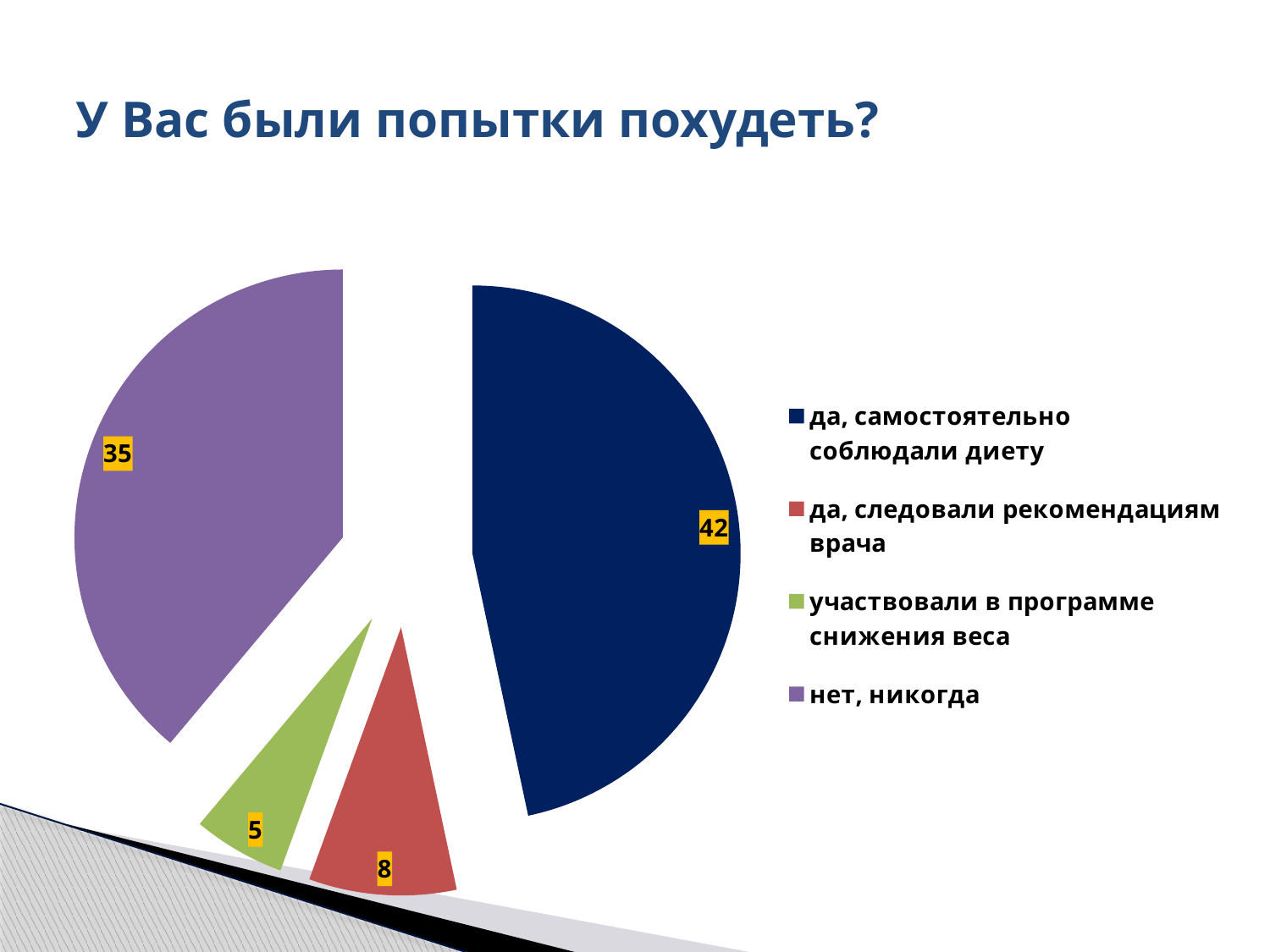
What value is shown for the slice 'участвовали в программе снижения веса'? 5 What is the difference between the values for 'да, следовали рекомендациям врача' and 'участвовали в программе снижения веса'? 3 What kind of chart is shown on the slide? pie chart What value is shown for the slice 'да, самостоятельно соблюдали диету'? 42 Which is larger: the value for 'нет, никогда' or the value for 'да, следовали рекомендациям врача'? нет, никогда Which category has the largest slice of the pie? да, самостоятельно соблюдали диету What value is shown for the slice 'да, следовали рекомендациям врача'? 8 What is the difference between the values for 'да, самостоятельно соблюдали диету' and 'нет, никогда'? 7 What is the title of the chart on the slide? У Вас были попытки похудеть? What value is shown for the slice 'нет, никогда'? 35 Which category has the smallest slice of the pie? участвовали в программе снижения веса How many categories does the pie chart show? 4